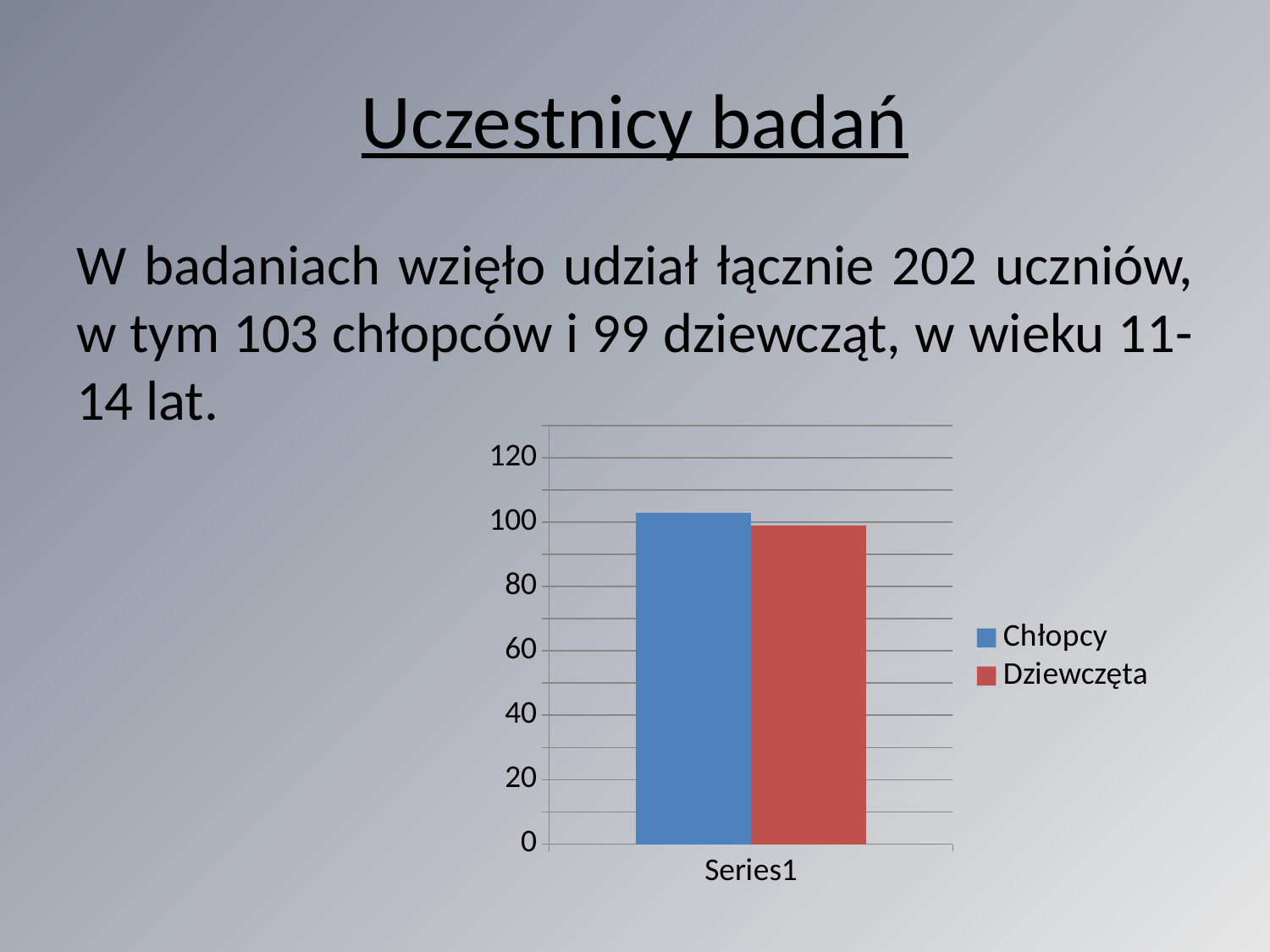
Which series is represented by the red bar? Dziewczęta What kind of chart is shown on the slide? bar chart Is the value for Dziewczęta greater or less than 80? greater Is the value for Chłopcy greater or less than 80? greater Is the value for Dziewczęta greater or less than 120? less How many series does the chart legend list? 2 What is the highest tick value shown on the vertical axis? 120 How many bars are plotted in the chart? 2 Which series is represented by the blue bar? Chłopcy Which bar is taller, Chłopcy or Dziewczęta? Chłopcy